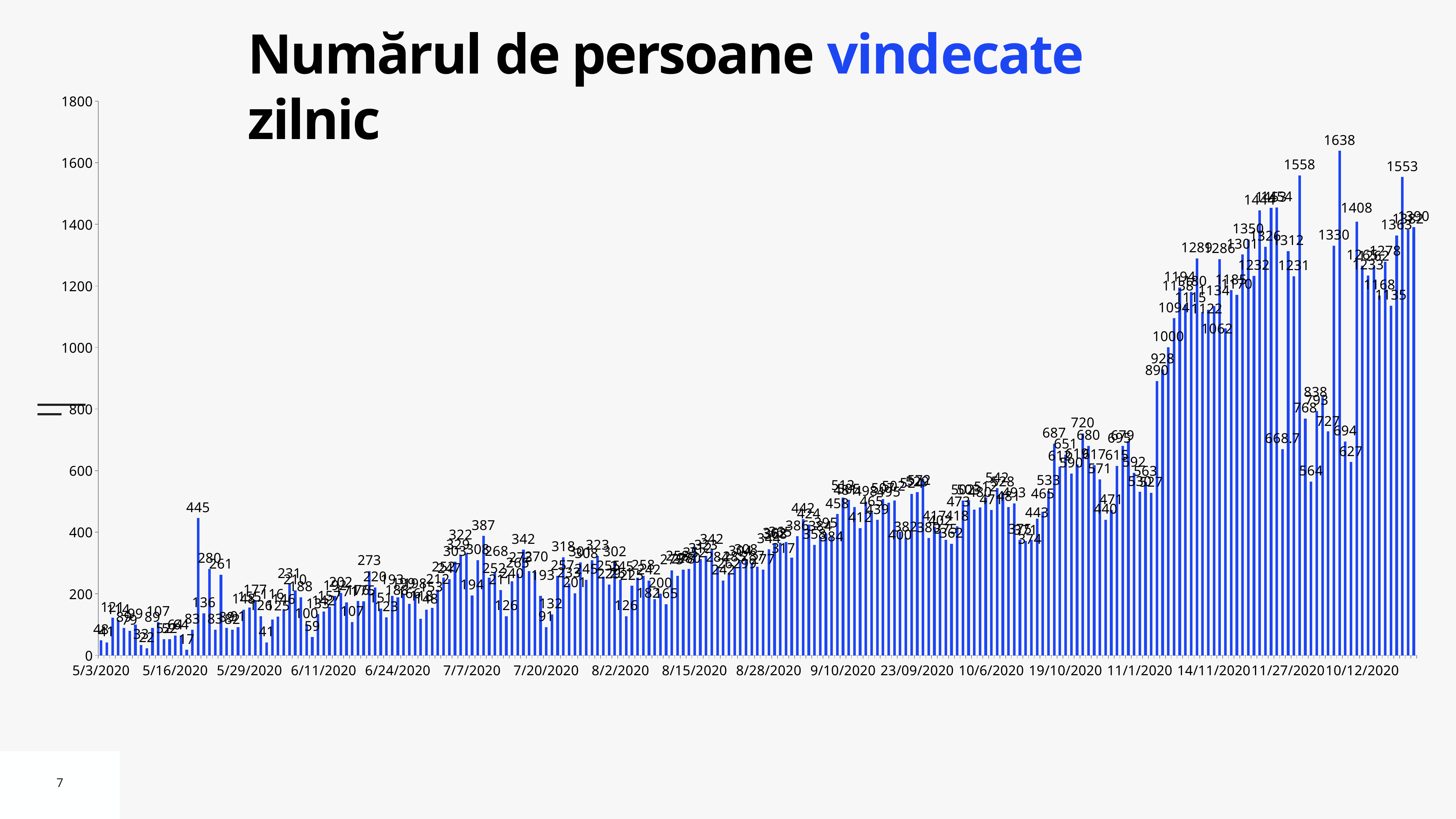
What is the lowest value labeled on the chart? 17 What is the maximum value shown on the vertical axis? 1800 What is the highest value labeled on the chart? 1638 What kind of chart is shown on the slide? bar chart Is the value for 5/3/2020 greater or less than 200? less What is the title of the chart? Numărul de persoane vindecate zilnic What is the value of the only bar before 6/11/2020 that exceeds 400? 445 Which bar is taller, the one at 5/3/2020 or the one at 10/12/2020? 10/12/2020 Is the value for 8/2/2020 greater or less than 600? less What is the difference between the highest labeled value (1638) and the second highest labeled value (1558)? 80 Is the value for 11/1/2020 greater or less than 400? greater Overall, do the values rise or fall from left to right along the x axis? rise